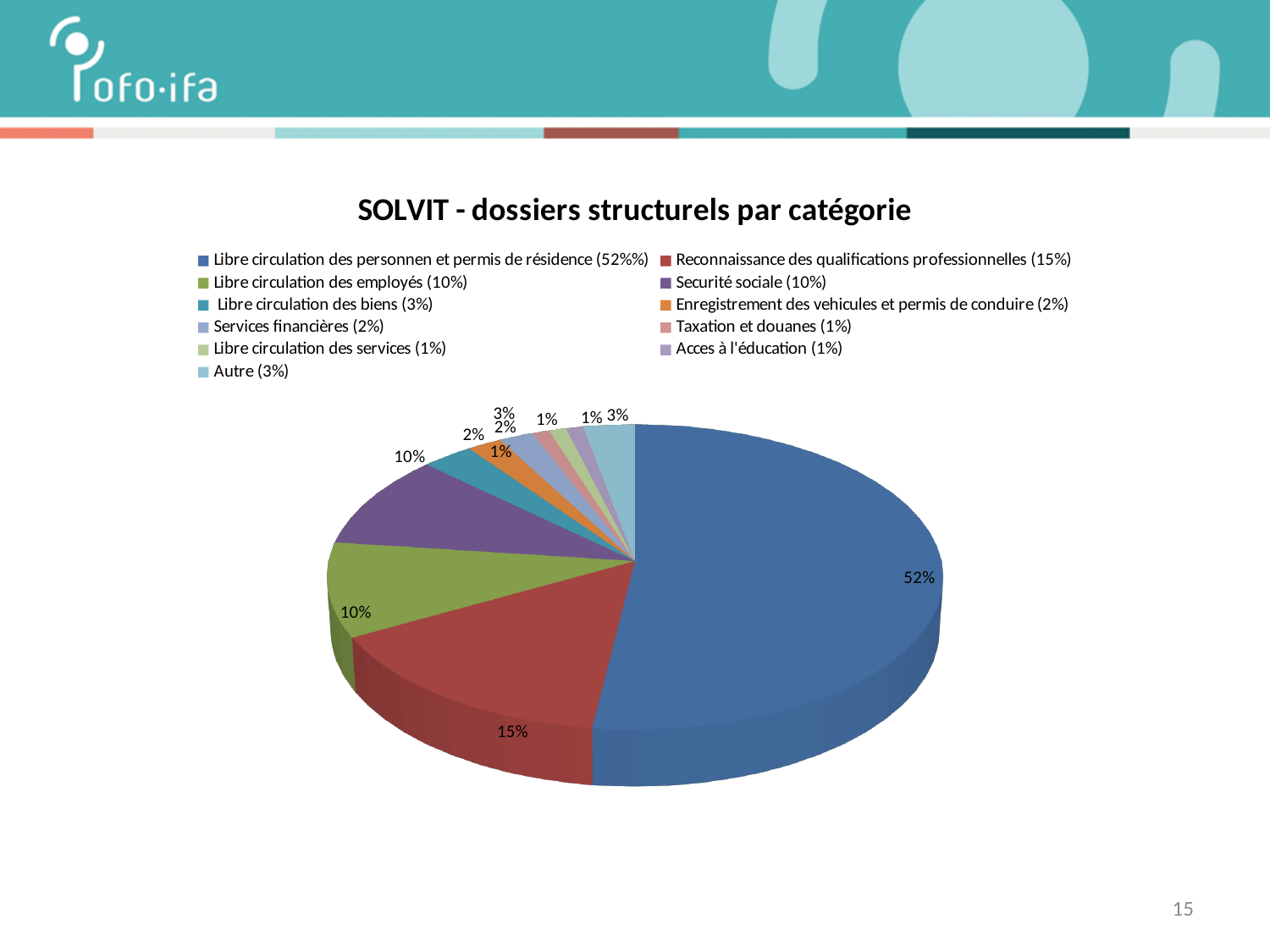
What is the value for 'Autre'? 3% What is the value for 'Services financières'? 2% What is the title of the chart? SOLVIT - dossiers structurels par catégorie What kind of chart is shown on the slide? pie chart What is the difference between the shares of 'Libre circulation des personnen et permis de résidence' and 'Reconnaissance des qualifications professionnelles'? 37% How many categories does the legend list? 11 Which is larger, the share for 'Reconnaissance des qualifications professionnelles' or the share for 'Libre circulation des employés'? Reconnaissance des qualifications professionnelles Which category has the largest slice of the pie? Libre circulation des personnen et permis de résidence What is the value for 'Libre circulation des biens'? 3% What is the value for 'Securité sociale'? 10% What share of the pie does 'Libre circulation des personnen et permis de résidence' represent? 52% What share of the pie does 'Reconnaissance des qualifications professionnelles' represent? 15%